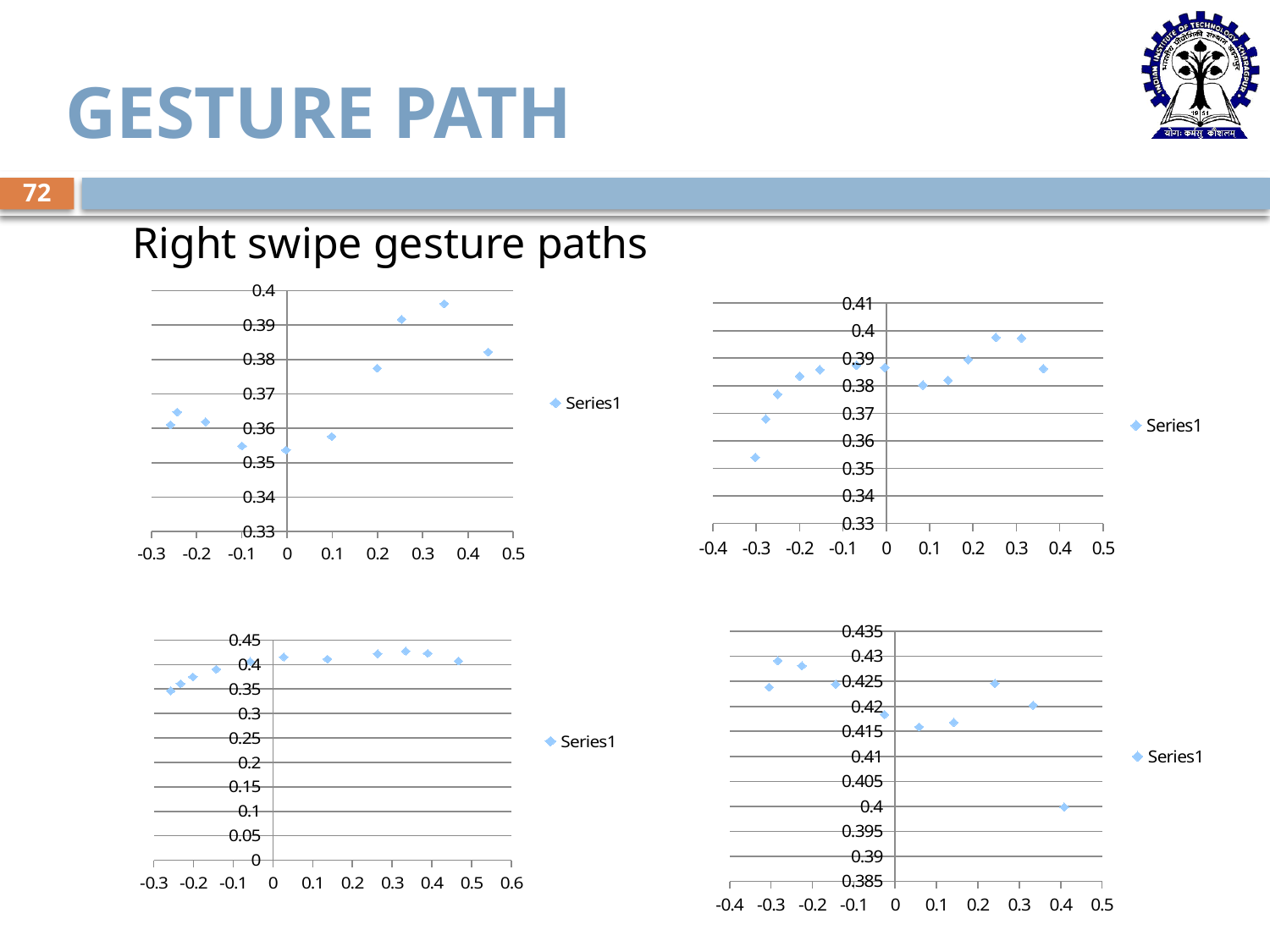
In the bottom-left chart, is the value of the leftmost point (at x = -0.25) greater or less than 0.4? less In the bottom-left chart, do the values generally rise or fall as x increases from -0.3 to 0.3? rise What kind of chart is the top-left chart on the slide? scatter chart In the top-left chart, is the value of the point at x = 0 greater or less than 0.36? less What is the highest value shown on the y axis of the bottom-left chart? 0.45 In the top-left chart, is the value of the point at x = 0.35 greater or less than 0.39? greater What is the legend entry shown for the bottom-left chart? Series1 How many series does the legend of the top-right chart list? 1 In the top-right chart, at which x value does the lowest point occur? -0.3